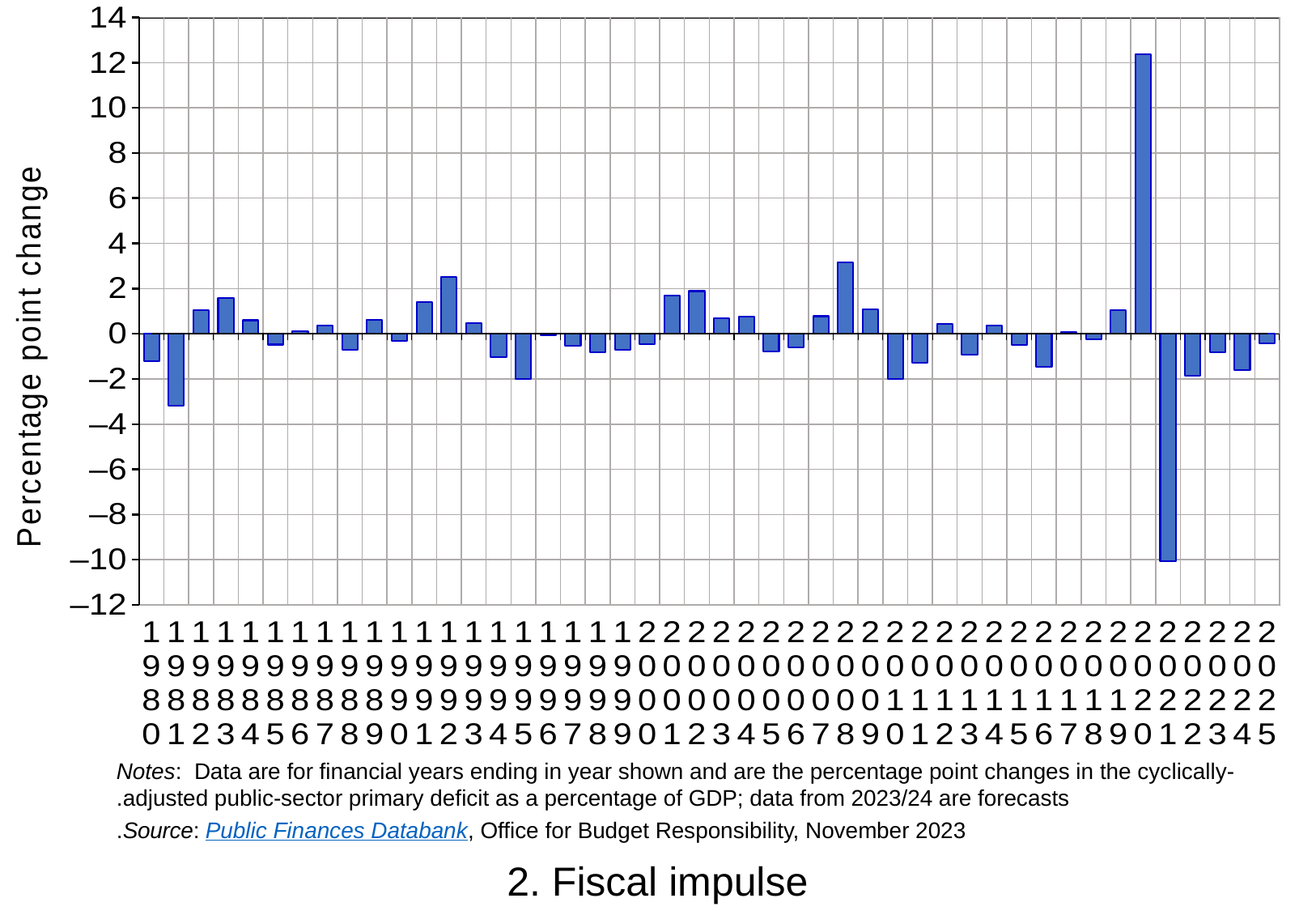
Is the value for 2021 greater or less than -8? less What kind of chart is shown on the slide? bar chart Is the value for 2020 greater or less than 10? greater Which year has the larger value, 1980 or 1981? 1980 Which year has the larger value, 2008 or 1992? 2008 Is the value for 1981 greater or less than -2? less What is the title of the chart? 2. Fiscal impulse How many years are plotted on the chart? 46 Which year has the lowest value? 2021 What is the label on the vertical axis? Percentage point change Which year has the highest value? 2020